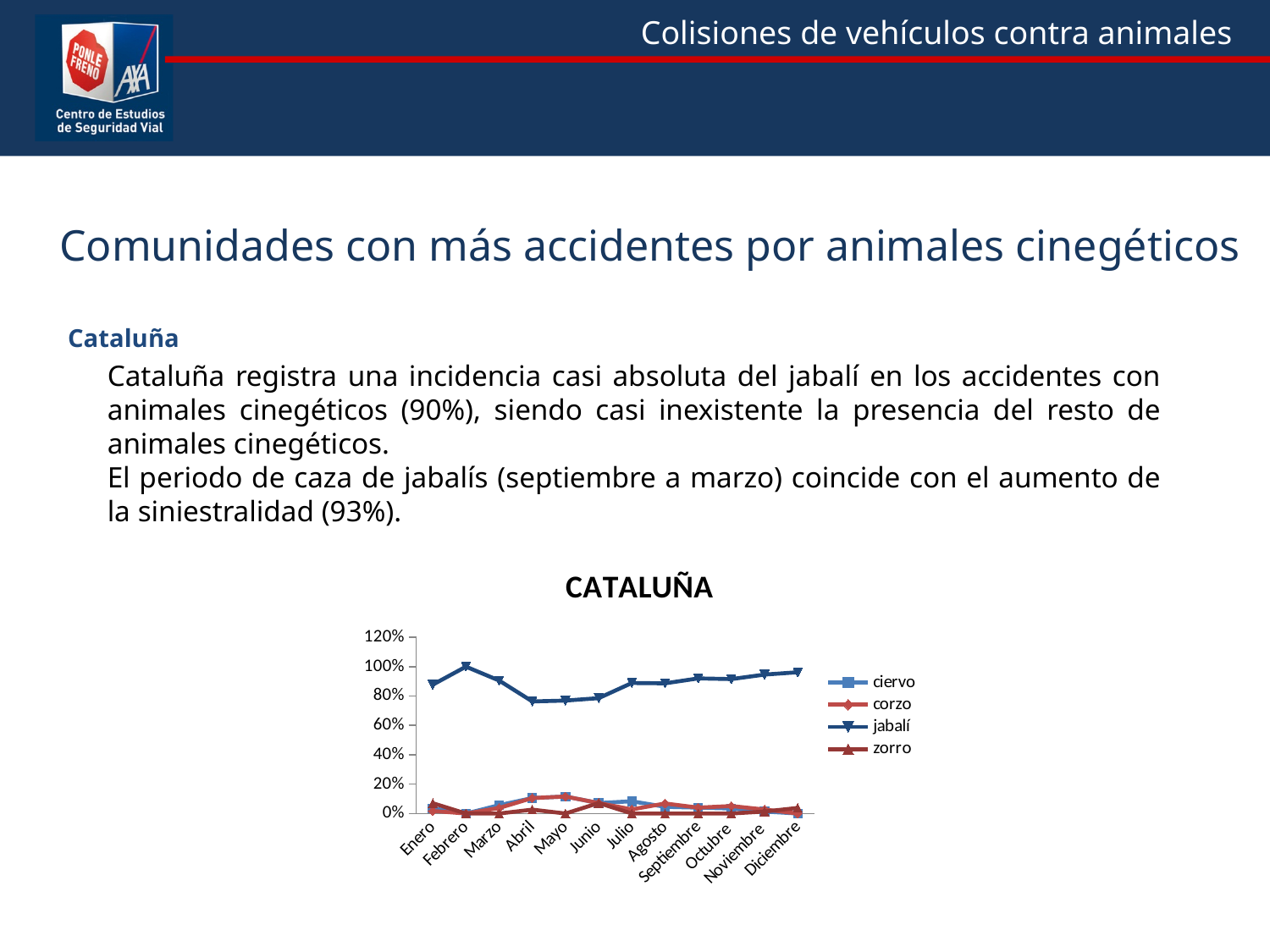
In which month does the jabalí series reach its highest value? Febrero Is the value for ciervo in Mayo greater or less than 20%? less What is the value for jabalí in Febrero? 100% What is the title of the chart? CATALUÑA How many series does the chart's legend list? 4 Is the value for jabalí in Abril greater or less than 60%? greater Which series are listed in the chart's legend? ciervo, corzo, jabalí, zorro What kind of chart is shown on the slide? line chart Which series has the highest value in Enero? jabalí Is the value for jabalí in Enero greater or less than 80%? greater Does the jabalí series rise or fall from Abril to Diciembre? rise How many months are shown along the x axis of the chart? 12